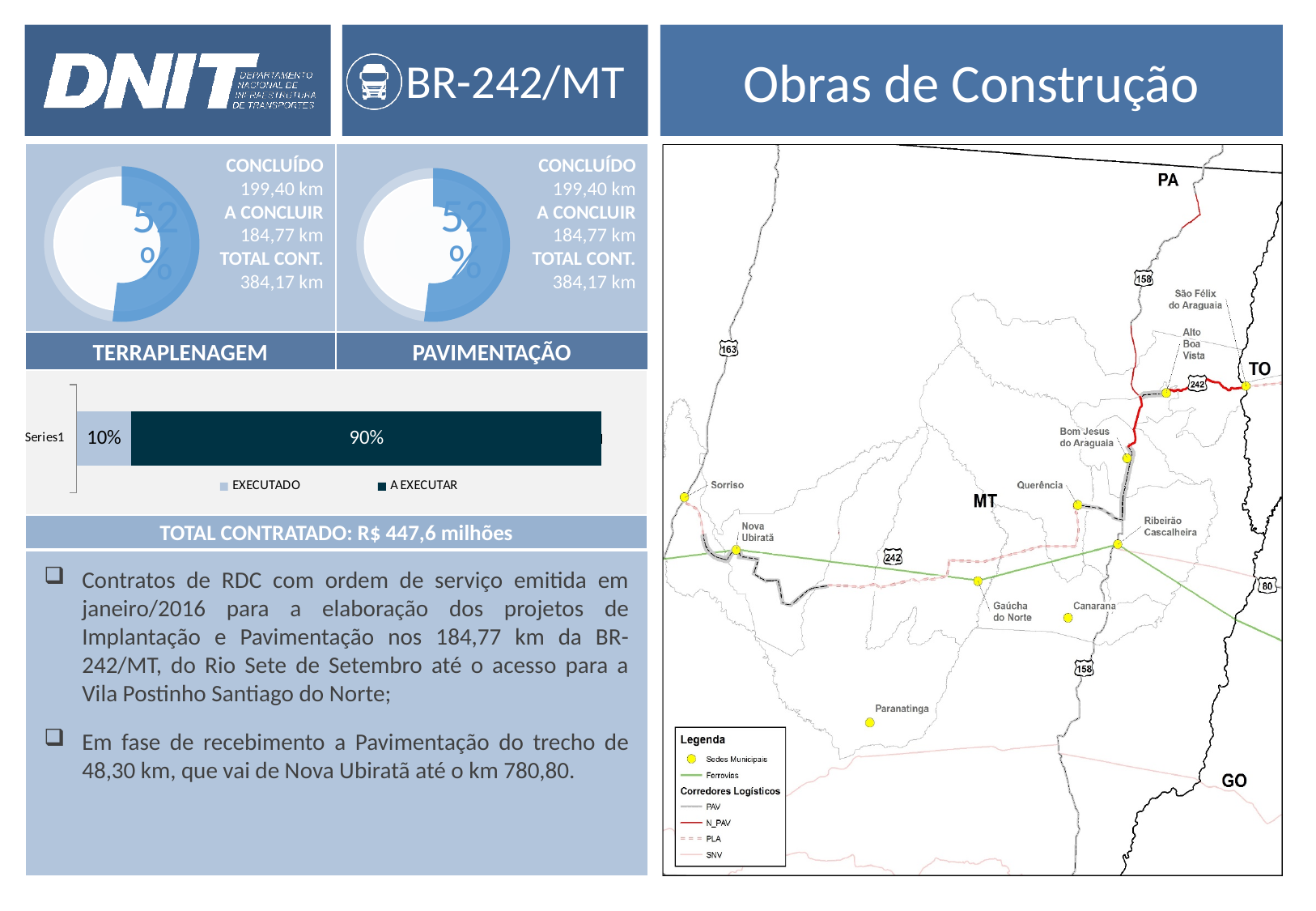
What kind of chart is the one with the EXECUTADO and A EXECUTAR legend? Stacked bar chart What percentage is shown in the centre of the TERRAPLENAGEM donut chart? 52% What is the category label on the vertical axis of the stacked bar chart? Series1 What is the TOTAL CONT. value shown next to the PAVIMENTAÇÃO donut chart? 384,17 km In the stacked bar chart, what is the difference between the A EXECUTAR and EXECUTADO values? 80 percentage points How many series does the legend of the stacked bar chart list? 2 In the stacked bar chart, what is the total of the Series1 bar? 100% In the stacked bar chart, which is larger, EXECUTADO or A EXECUTAR? A EXECUTAR In the stacked bar chart, what is the value for A EXECUTAR? 90% What percentage is shown in the centre of the PAVIMENTAÇÃO donut chart? 52% In the stacked bar chart, what is the value for EXECUTADO? 10% What is the CONCLUÍDO value shown next to the TERRAPLENAGEM donut chart? 199,40 km